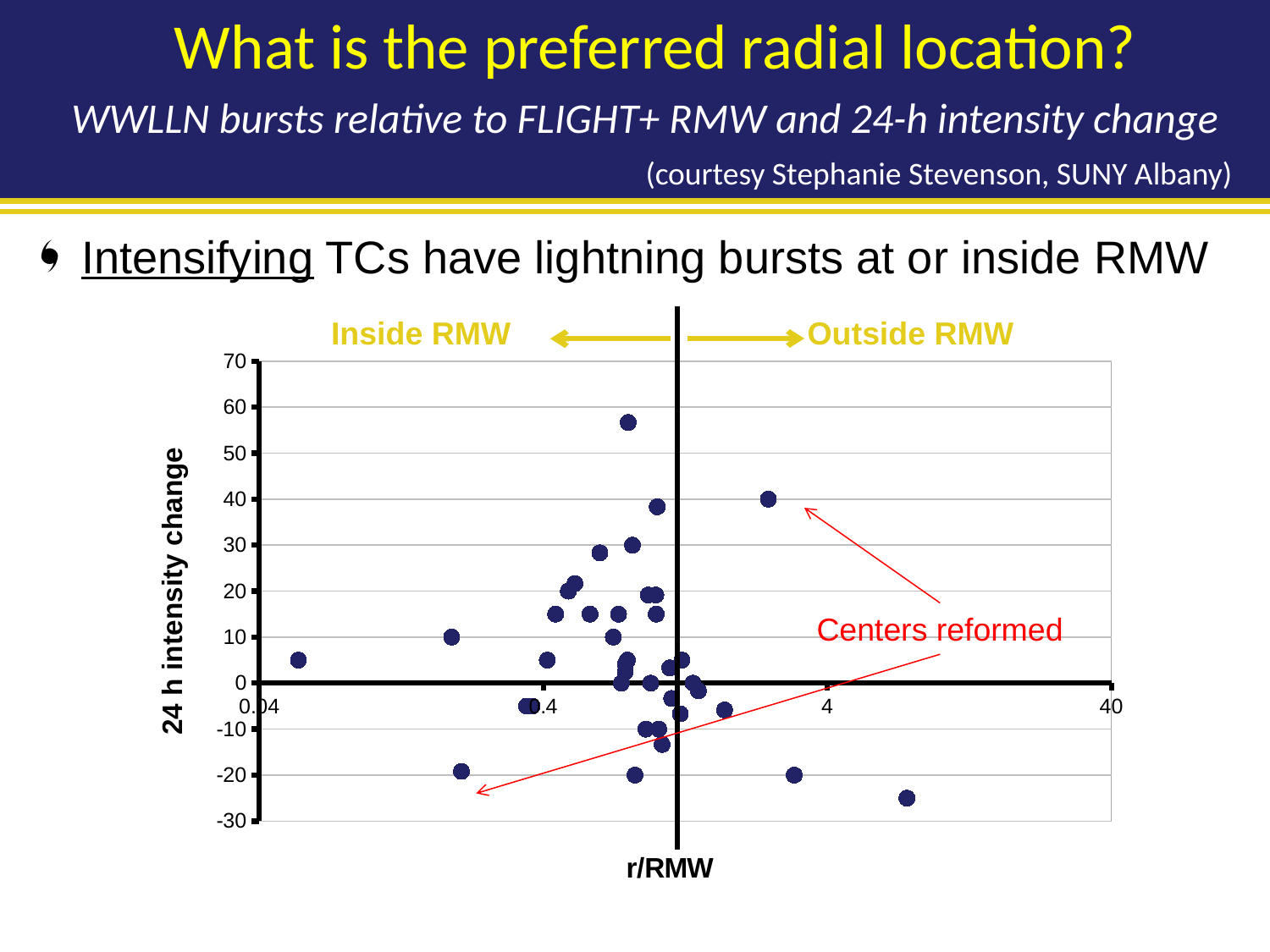
Is the 24 h intensity change of the point plotted at r/RMW of about 0.04 greater or less than 10? less What is the label of the horizontal axis of the chart? r/RMW What kind of chart is shown on the slide? scatter plot Is the 24 h intensity change of the rightmost point on the chart (near r/RMW of 10) greater or less than -20? less Is the lowest 24 h intensity change plotted on the chart greater or less than -20? less What is the label of the vertical axis of the chart? 24 h intensity change